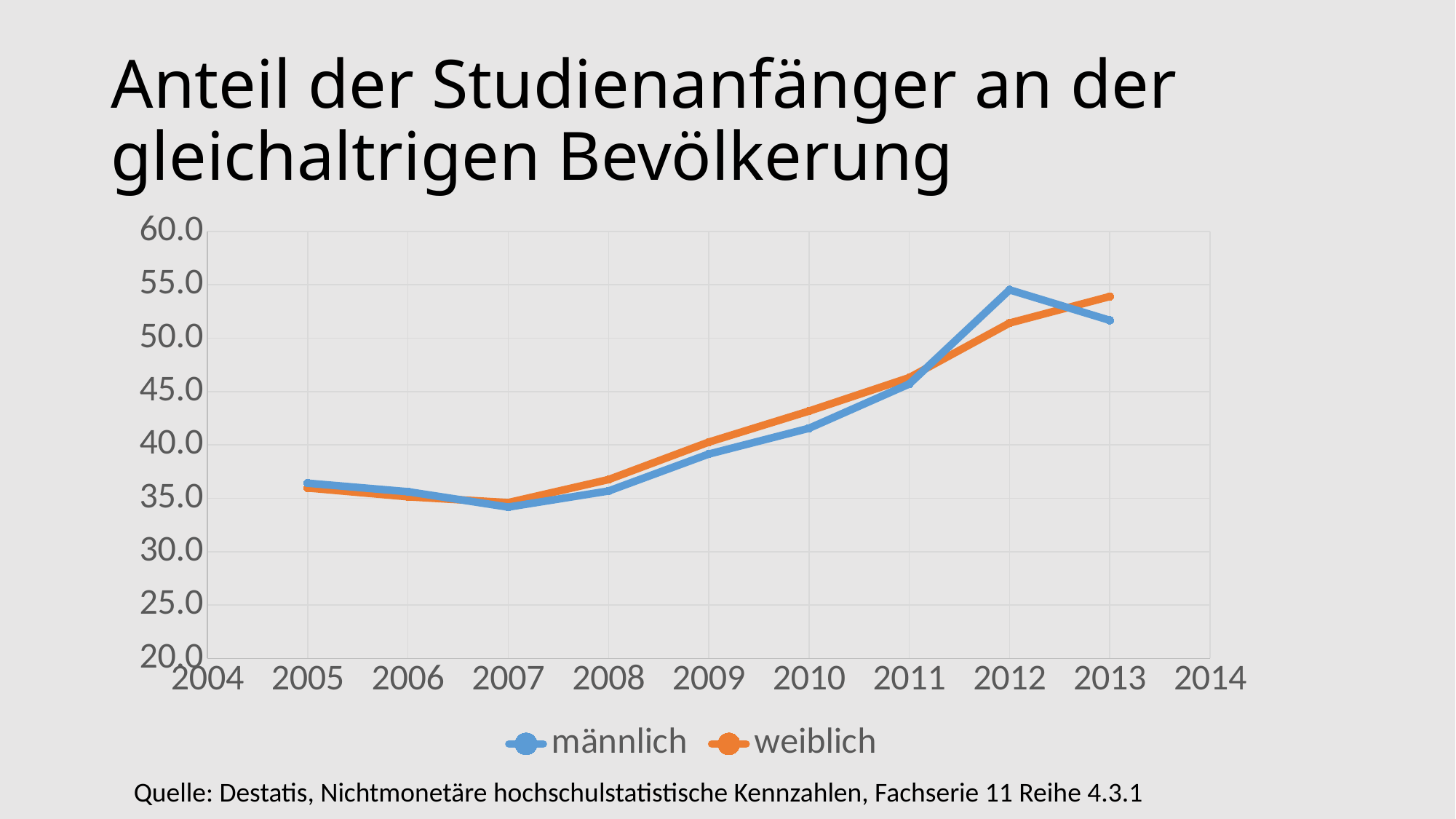
Is the value for männlich in 2012 greater or less than 50.0? greater How many series does the legend list? 2 What kind of chart is shown on the slide? line chart In which year does the männlich series reach its highest value? 2012 Is the value for männlich in 2007 greater or less than 35.0? less Is the value for weiblich in 2011 greater or less than 45.0? greater How many years have data points plotted for each series? 9 What are the two series named in the legend? männlich and weiblich In 2013, which series has the larger value, männlich or weiblich? weiblich In which year does the weiblich series reach its highest value? 2013 Does the weiblich series rise or fall between 2007 and 2013? rise In which year does the männlich series reach its lowest value? 2007